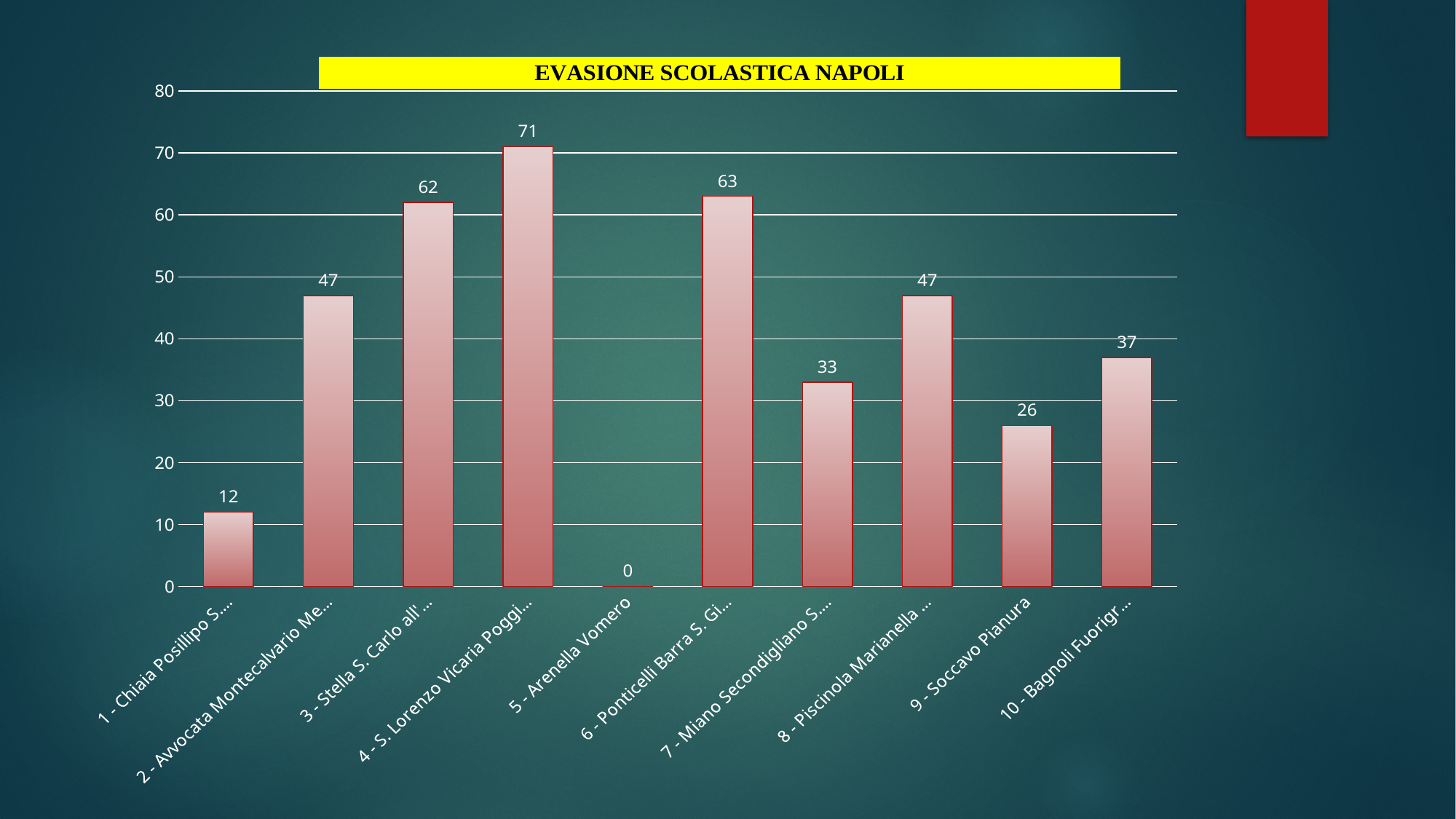
How many categories are shown on the x axis? 10 What is the value for 9 - Soccavo Pianura? 26 Which category has the highest value? 4 - S. Lorenzo Vicaria Poggi... Which is larger, the value for 3 - Stella S. Carlo all'... or the value for 6 - Ponticelli Barra S. Gi...? 6 - Ponticelli Barra S. Gi... What is the title of the chart? EVASIONE SCOLASTICA NAPOLI What is the value for 5 - Arenella Vomero? 0 Which two categories share the same value of 47? 2 - Avvocata Montecalvario Me... and 8 - Piscinola Marianella ... Which category has the lowest value? 5 - Arenella Vomero What is the value for the first category, 1 - Chiaia Posillipo? 12 What is the difference between the values for 4 - S. Lorenzo Vicaria Poggi... and 1 - Chiaia Posillipo? 59 What is the difference between the values for 6 - Ponticelli Barra S. Gi... and 7 - Miano Secondigliano S....? 30 What kind of chart is this? Bar chart